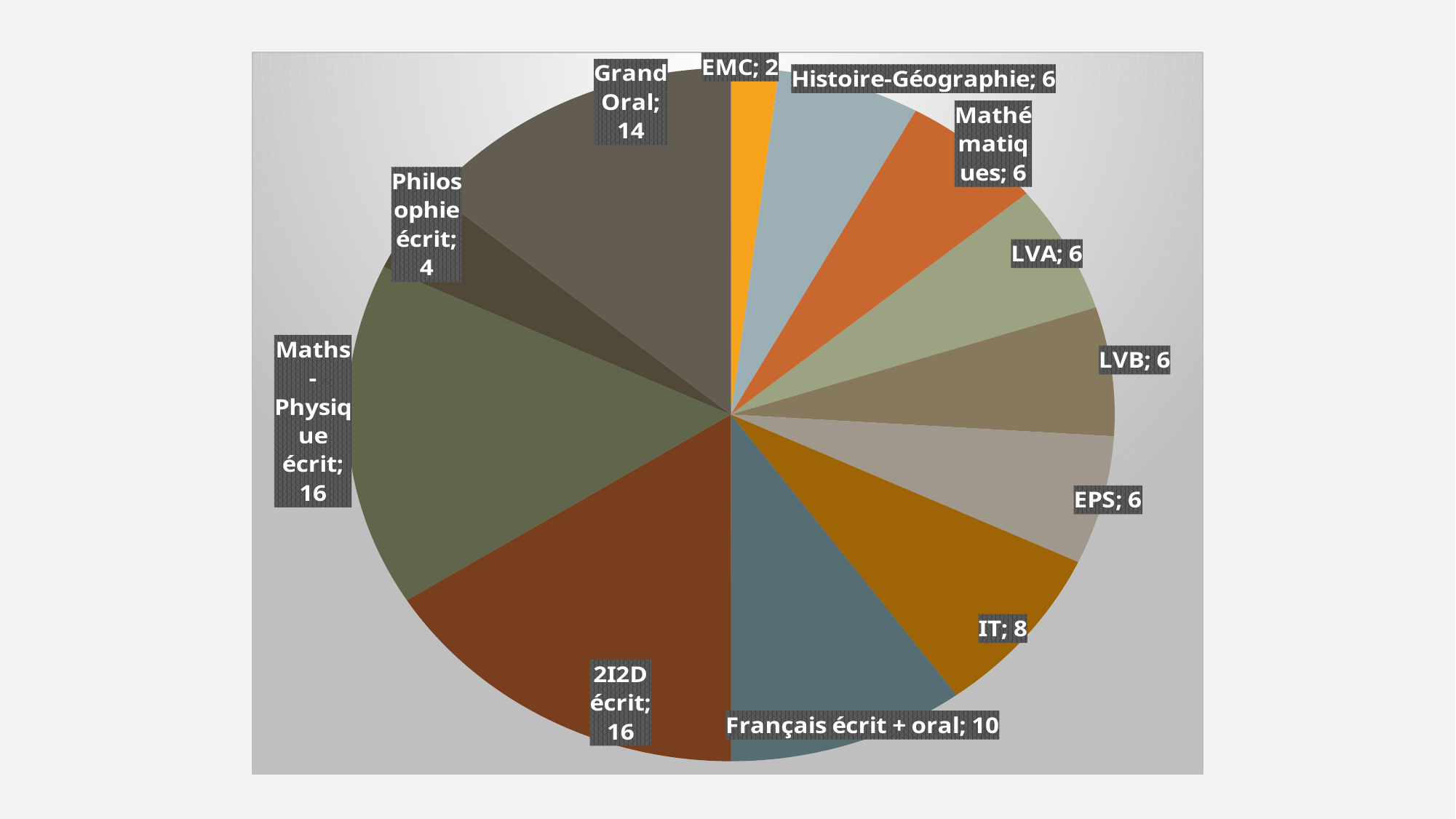
What is the difference between the values for 2I2D écrit and IT? 8 Which category has the smallest slice? EMC What share of the pie does EMC represent? 2% What type of chart is shown on the slide? pie chart What share of the pie does Maths-Physique écrit represent? 16% Which is larger, the value for Grand Oral or the value for Philosophie écrit? Grand Oral What is the value for Français écrit + oral? 10 What is the value for IT? 8 What is the value for Grand Oral? 14 What is the value for Philosophie écrit? 4 What is the difference between the values for Grand Oral and Français écrit + oral? 4 How many slices does the pie chart have? 12